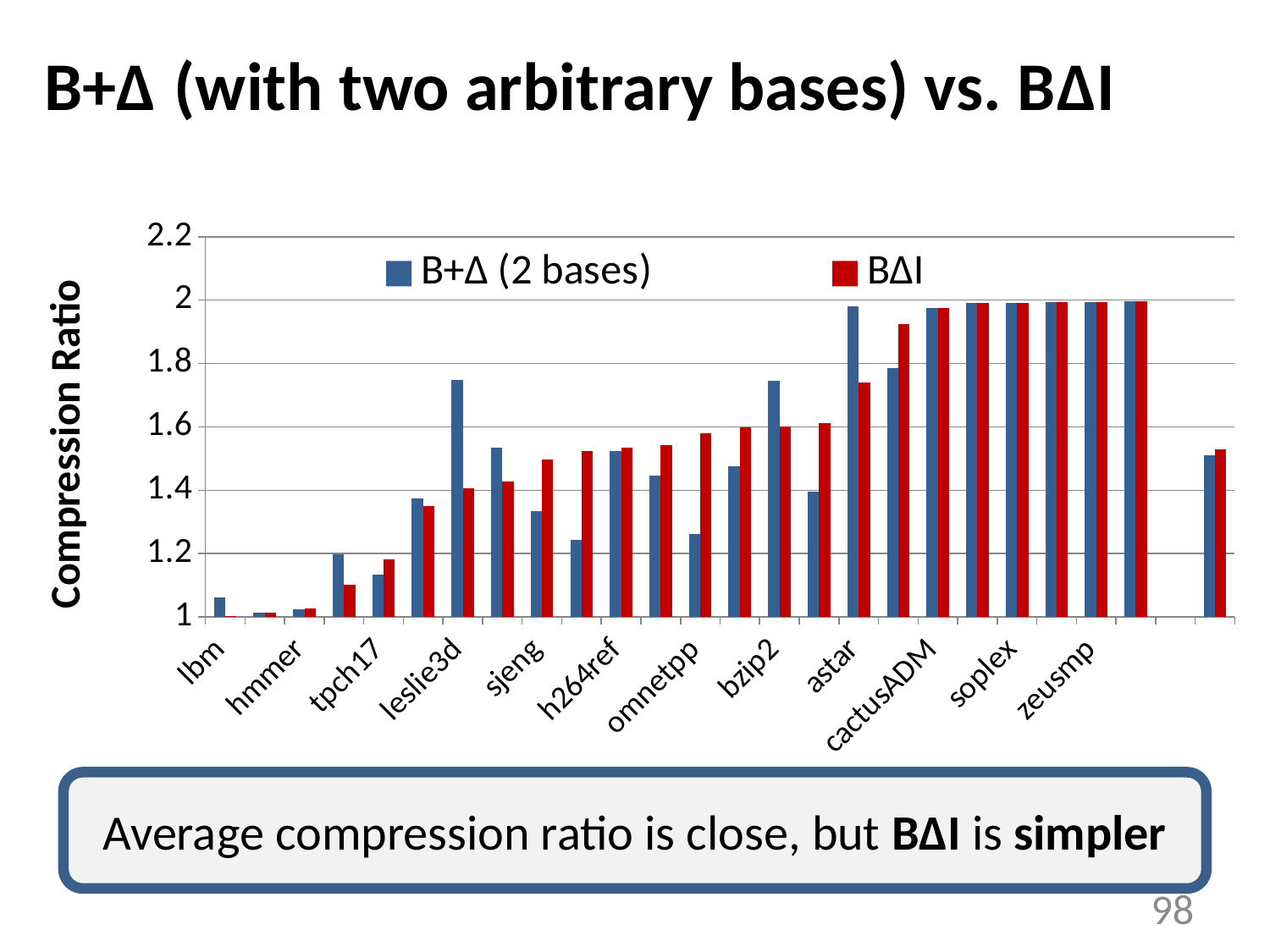
How many series does the legend list? 2 What is the label on the vertical axis? Compression Ratio Is the BΔI value for omnetpp greater or less than 1.4? greater For leslie3d, which series has the larger value, B+Δ (2 bases) or BΔI? B+Δ (2 bases) Is the B+Δ (2 bases) value for astar greater or less than 1.8? greater Is the B+Δ (2 bases) value for sjeng greater or less than 1.4? less What are the two series named in the legend? B+Δ (2 bases) and BΔI For omnetpp, which series has the larger value, B+Δ (2 bases) or BΔI? BΔI Do the BΔI values generally rise or fall moving from lbm to zeusmp along the x axis? rise What kind of chart is shown on the slide? bar chart